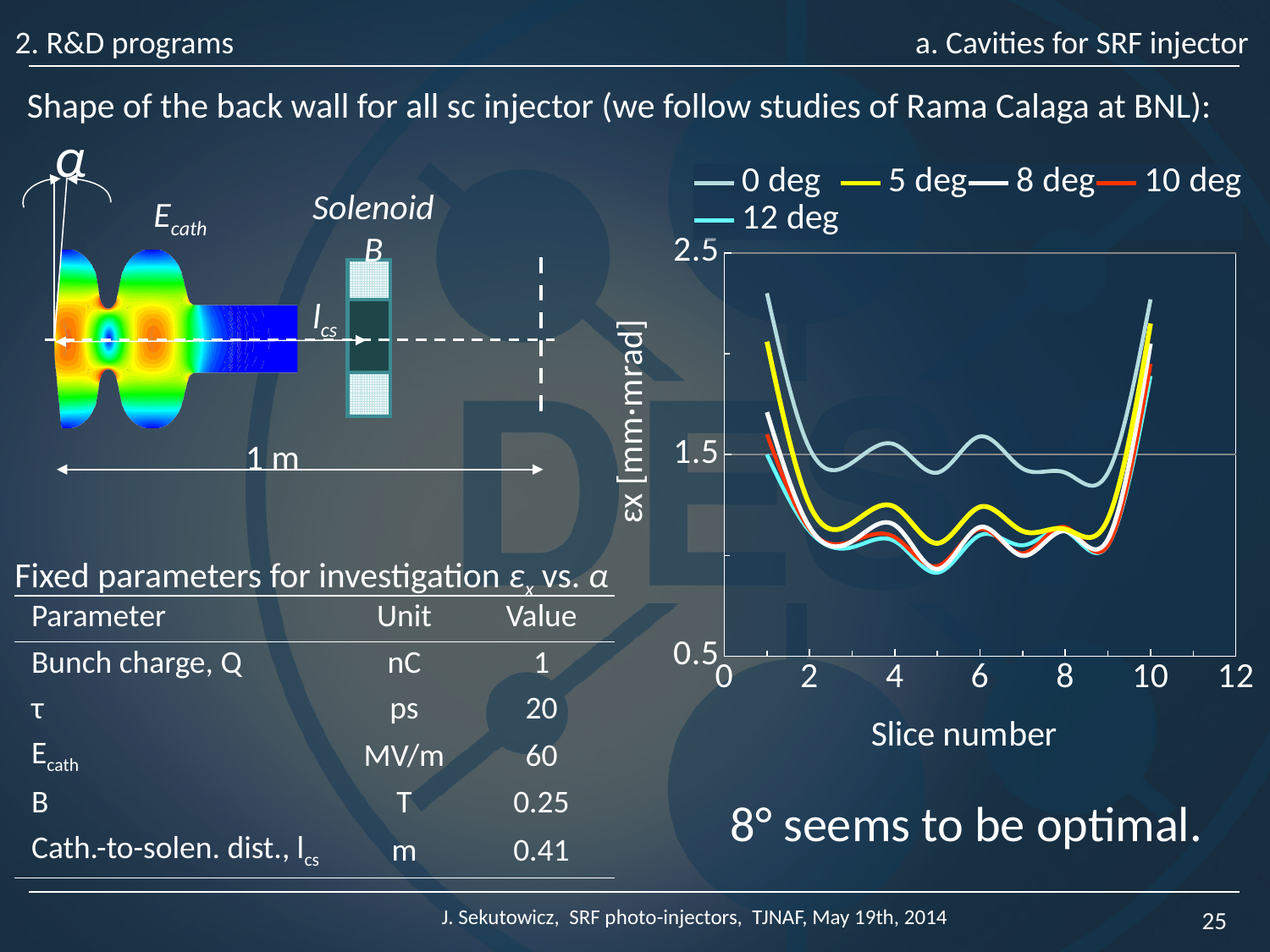
At slice number 5, which series has the larger εx value, 0 deg or 12 deg? 0 deg Is the εx value for the 0 deg series at slice number 1 greater or less than 1.5? greater At slice number 1, which series has the larger εx value, 0 deg or 5 deg? 0 deg Is the εx value for the 12 deg series at slice number 5 greater or less than 1.5? less What kind of chart is shown on the slide? line chart Which angle does the slide conclude seems to be optimal? 8° What is the label of the y axis of the chart? εx [mm·mrad] Is the εx value for the 5 deg series at slice number 5 greater or less than 1.5? less What is the label of the x axis of the chart? Slice number How many series does the chart legend list? 5 How many slice numbers are plotted for each series? 10 Which series has the highest εx values across the middle slices (slices 2 to 9)? 0 deg